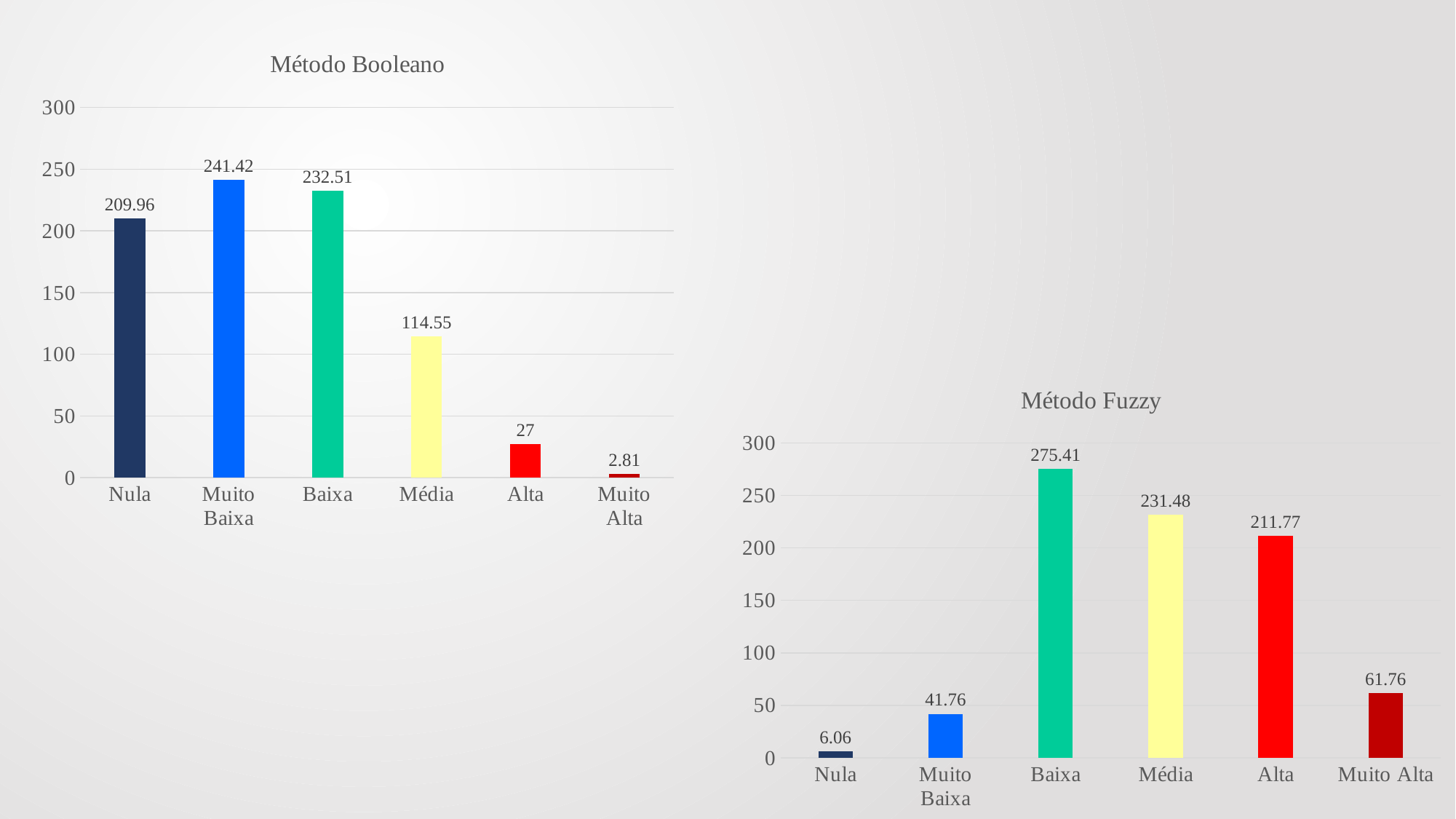
In the Método Fuzzy chart, what is the difference between the values for Baixa and Média? 43.93 In the Método Booleano chart, which category has the lowest value? Muito Alta In the Método Fuzzy chart, is the value for Muito Alta greater or less than 50? greater How many categories are shown in the Método Fuzzy chart? 6 What kind of chart is the Método Booleano chart? bar chart In the Método Booleano chart, what is the difference between the values for Muito Baixa and Baixa? 8.91 In the Método Fuzzy chart, which category has the highest value? Baixa In the Método Fuzzy chart, what is the value for Alta? 211.77 What is the title of the chart on the right side of the slide? Método Fuzzy In the Método Fuzzy chart, which category has the lowest value? Nula In the Método Booleano chart, which is larger, the value for Nula or the value for Média? Nula In the Método Booleano chart, what is the value for Muito Baixa? 241.42